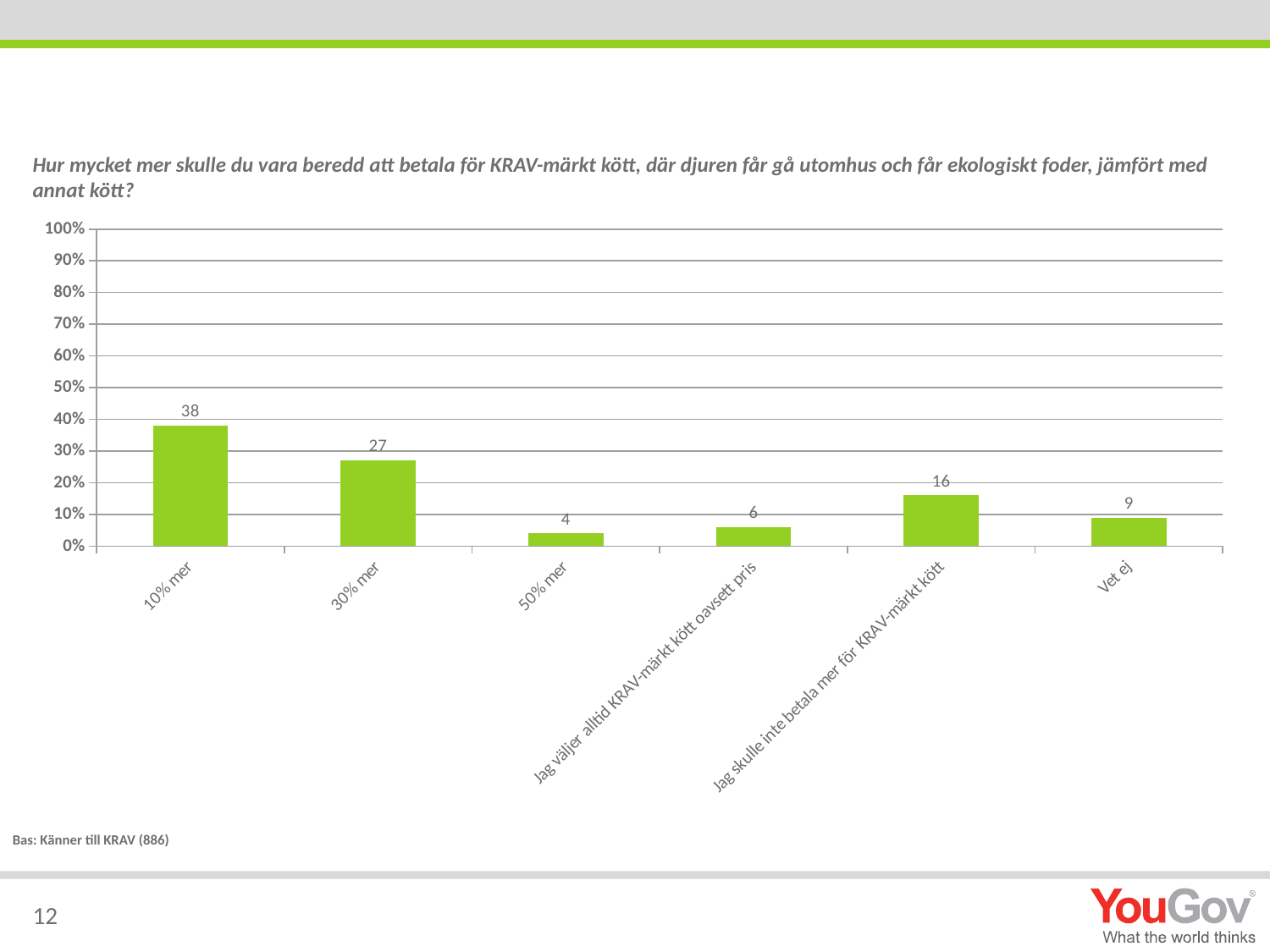
What is the difference between the values for "10% mer" and "30% mer"? 11 What is the value for "50% mer"? 4 What is the value for "30% mer"? 27 Which is larger, the value for "Jag väljer alltid KRAV-märkt kött oavsett pris" or the value for "Vet ej"? Vet ej Which category has the highest value? 10% mer What is the value for "10% mer"? 38 What is the value for "Vet ej"? 9 What kind of chart is shown on the slide? Bar chart Which category has the lowest value? 50% mer What is the base (Bas) stated below the chart? Känner till KRAV (886) How many categories are shown on the x axis? 6 What is the value for "Jag skulle inte betala mer för KRAV-märkt kött"? 16